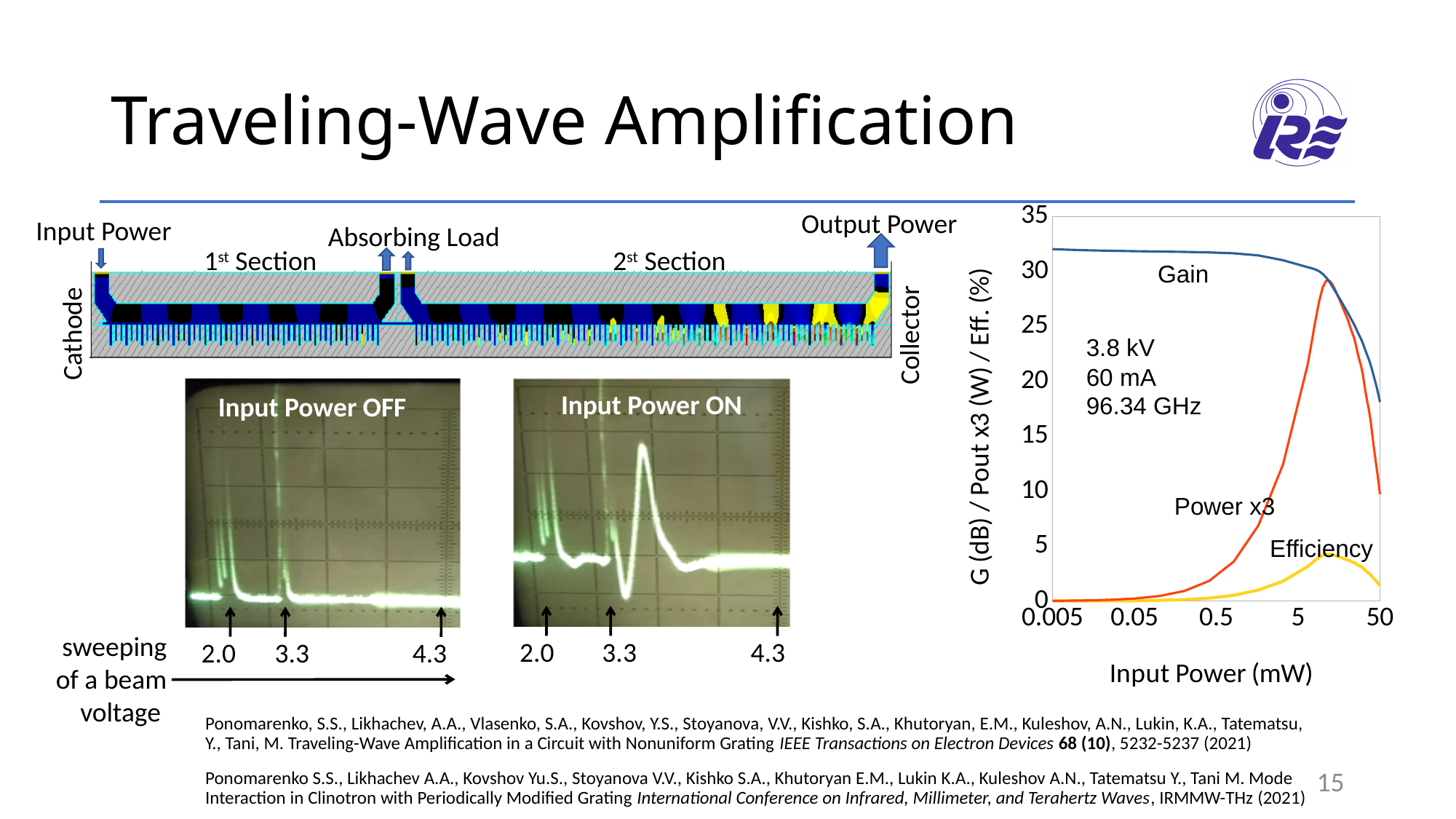
How many curves are plotted in the chart on the right? 3 What kind of chart is shown on the right of the slide? line chart In the chart on the right, is the Gain value at 50 mW greater or less than 20? less In the chart on the right, is the Efficiency value at 5 mW greater or less than 5? less In the chart on the right, is the Power x3 value at 50 mW greater or less than 5? greater In the chart on the right, at 0.5 mW input power, which curve is higher: Gain or Power x3? Gain In the chart on the right, does the Gain curve rise or fall as Input Power increases along the x axis? fall In the chart on the right, does the Power x3 curve rise or fall between 0.5 mW and 5 mW? rise What is the x-axis label of the chart on the right? Input Power (mW) What frequency is annotated on the chart on the right? 96.34 GHz